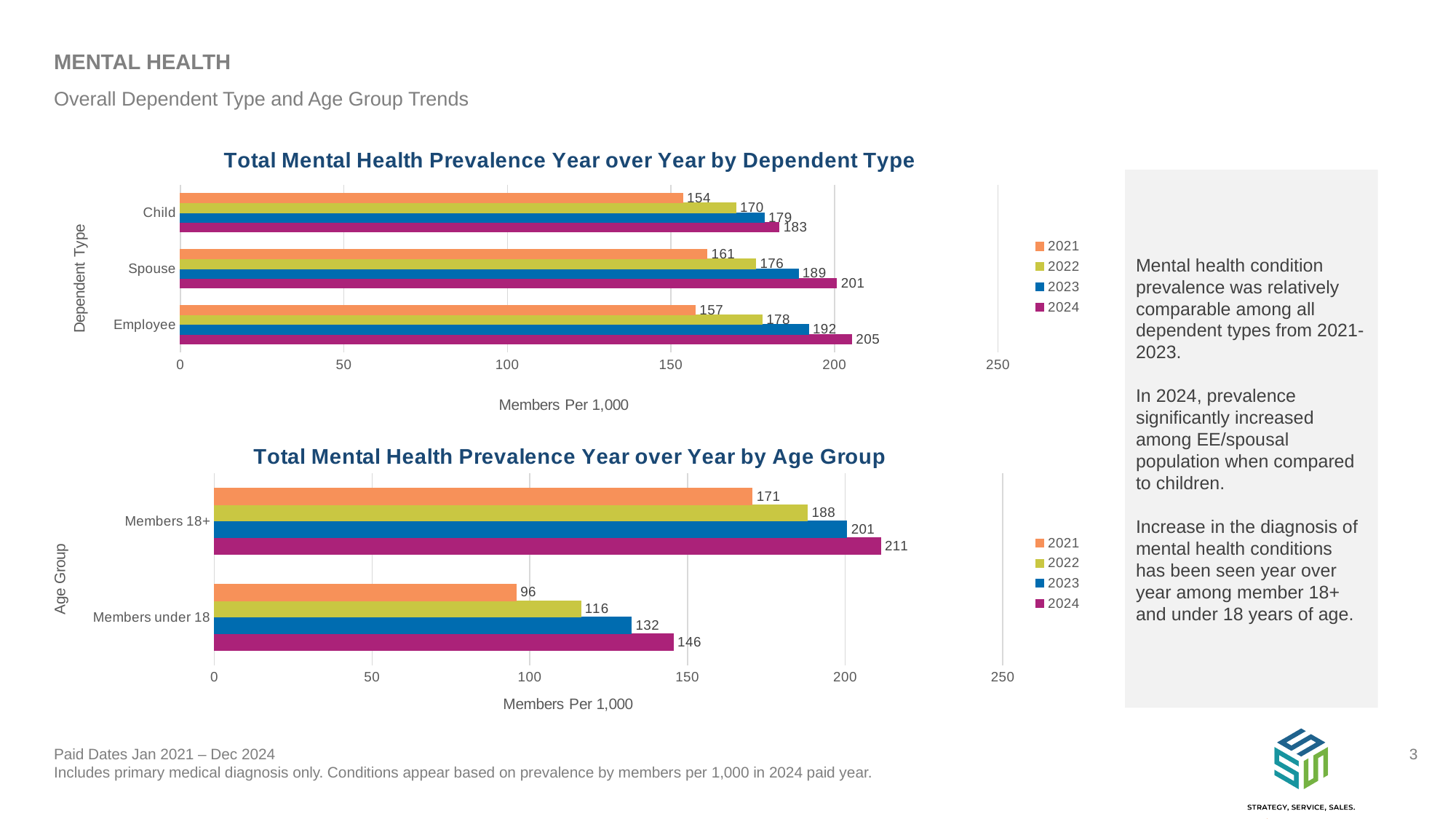
In the 'Total Mental Health Prevalence Year over Year by Dependent Type' chart, what is the difference between the Employee values for 2024 and 2021? 48 In the 'Total Mental Health Prevalence Year over Year by Age Group' chart, what is the difference between Members 18+ and Members under 18 in 2024? 65 In the 'Total Mental Health Prevalence Year over Year by Age Group' chart, which age group has the lowest value in 2021? Members under 18 In the 'Total Mental Health Prevalence Year over Year by Dependent Type' chart, which dependent type has the highest value in 2024? Employee What type of chart is the 'Total Mental Health Prevalence Year over Year by Age Group' chart? bar chart In the 'Total Mental Health Prevalence Year over Year by Dependent Type' chart, what is the value for Child in 2021? 154 In the 'Total Mental Health Prevalence Year over Year by Dependent Type' chart, do the values for Child rise or fall from 2021 to 2024? rise In the 'Total Mental Health Prevalence Year over Year by Age Group' chart, how many age group categories are shown? 2 In the 'Total Mental Health Prevalence Year over Year by Age Group' chart, what is the value for Members under 18 in 2023? 132 In the 'Total Mental Health Prevalence Year over Year by Age Group' chart, what is the value for Members 18+ in 2022? 188 In the 'Total Mental Health Prevalence Year over Year by Dependent Type' chart, what is the value for Spouse in 2024? 201 In the 'Total Mental Health Prevalence Year over Year by Dependent Type' chart, how many series does the legend list? 4